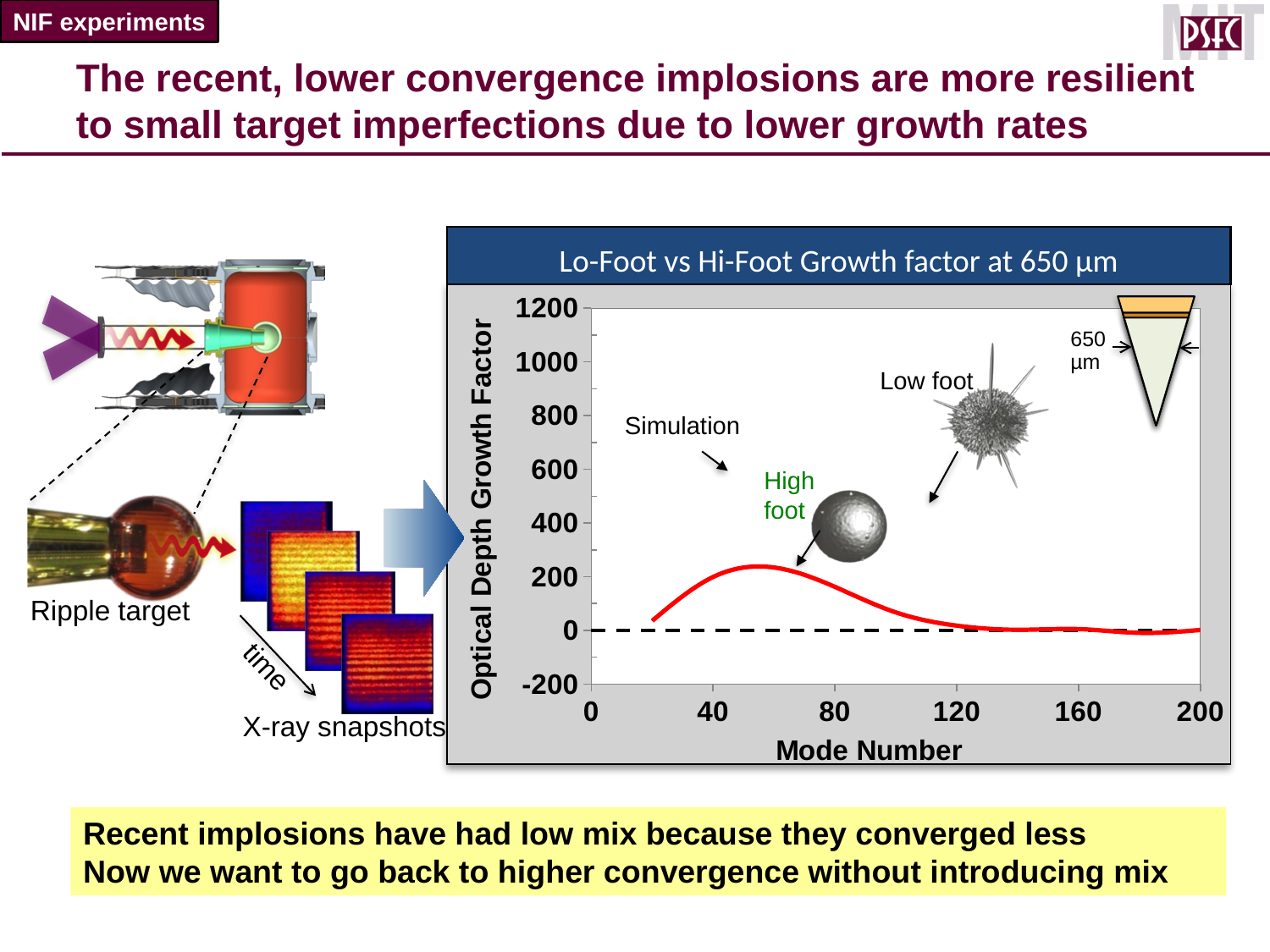
Is the value of the red curve at mode number 120 greater or less than 400? less What is the highest value shown on the y axis? 1200 Is the peak value of the red High foot curve greater or less than 400? less What kind of chart is shown on the slide? line chart Does the red curve rise or fall between mode number 20 and mode number 50? rise Does the red curve rise or fall between mode number 80 and mode number 120? fall Is the value of the red curve at mode number 40 greater or less than 0? greater What is the label of the x axis of the chart? Mode Number What is the lowest value shown on the y axis? -200 What is the highest mode number shown on the x axis? 200 What is the title of the chart? Lo-Foot vs Hi-Foot Growth factor at 650 μm